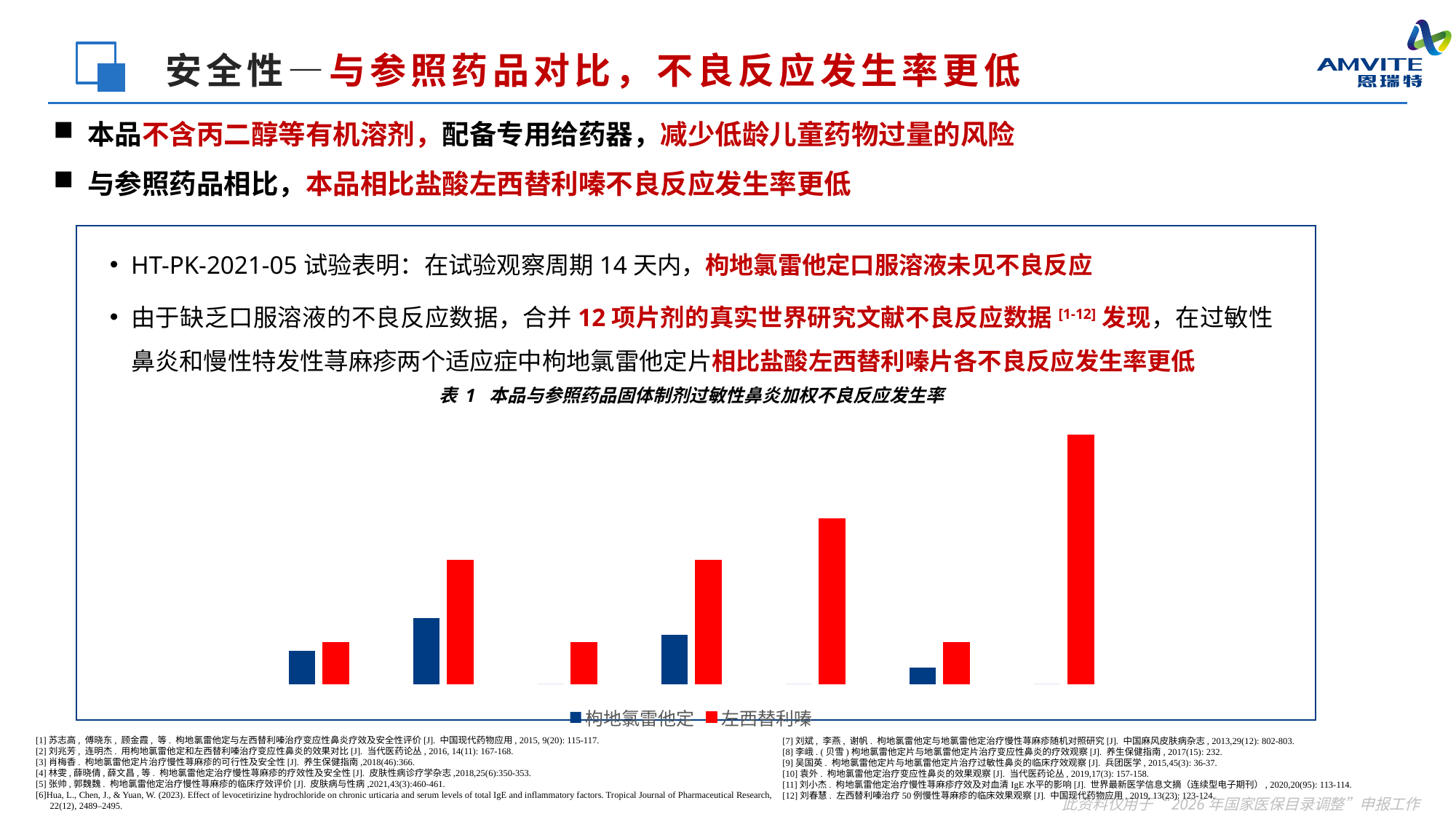
How many series does the chart legend list? 2 Which series has the tallest bar in the chart? 左西替利嗪 In each group of bars, which series has the taller bar, 枸地氯雷他定 or 左西替利嗪? 左西替利嗪 How many groups of bars are plotted in the chart? 7 Which colour represents 左西替利嗪 in the chart? red What are the two series named in the chart legend? 枸地氯雷他定 and 左西替利嗪 What kind of chart is shown on the slide? bar chart